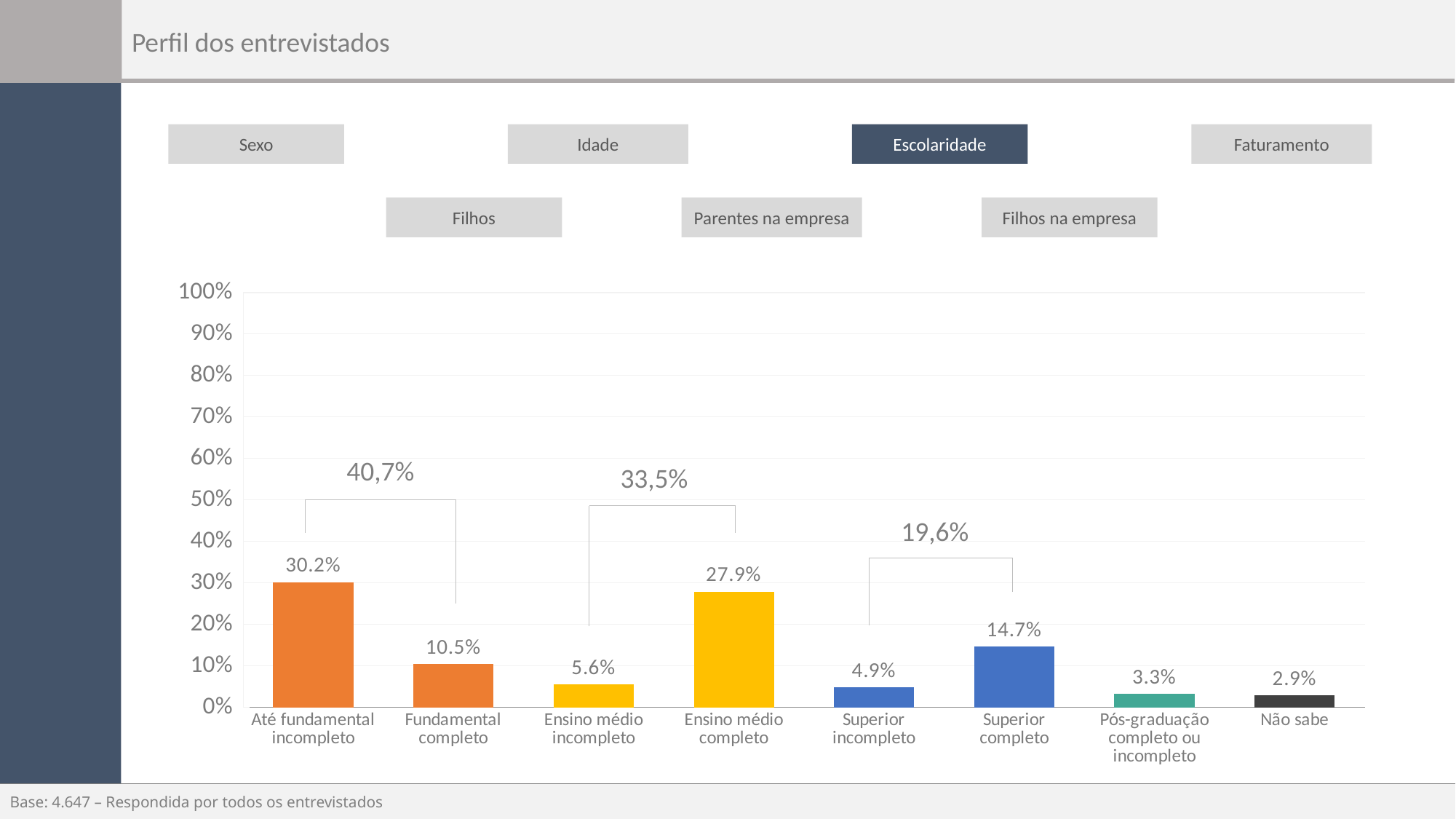
What combined percentage is shown by the bracket over the two 'Ensino médio' bars? 33,5% Which education category has the highest percentage? Até fundamental incompleto What is the value shown for 'Pós-graduação completo ou incompleto'? 3.3% What is the difference between 'Até fundamental incompleto' and 'Ensino médio completo'? 2.3 percentage points Which tab is highlighted above the chart? Escolaridade Is the value for 'Ensino médio incompleto' greater or less than 10%? less What percentage of respondents have 'Até fundamental incompleto'? 30.2% Which category has the lowest percentage? Não sabe Which is larger, 'Fundamental completo' or 'Superior completo'? Superior completo What is the value shown for 'Superior completo'? 14.7% What kind of chart is shown on the slide? Bar chart How many education categories are shown on the x axis? 8